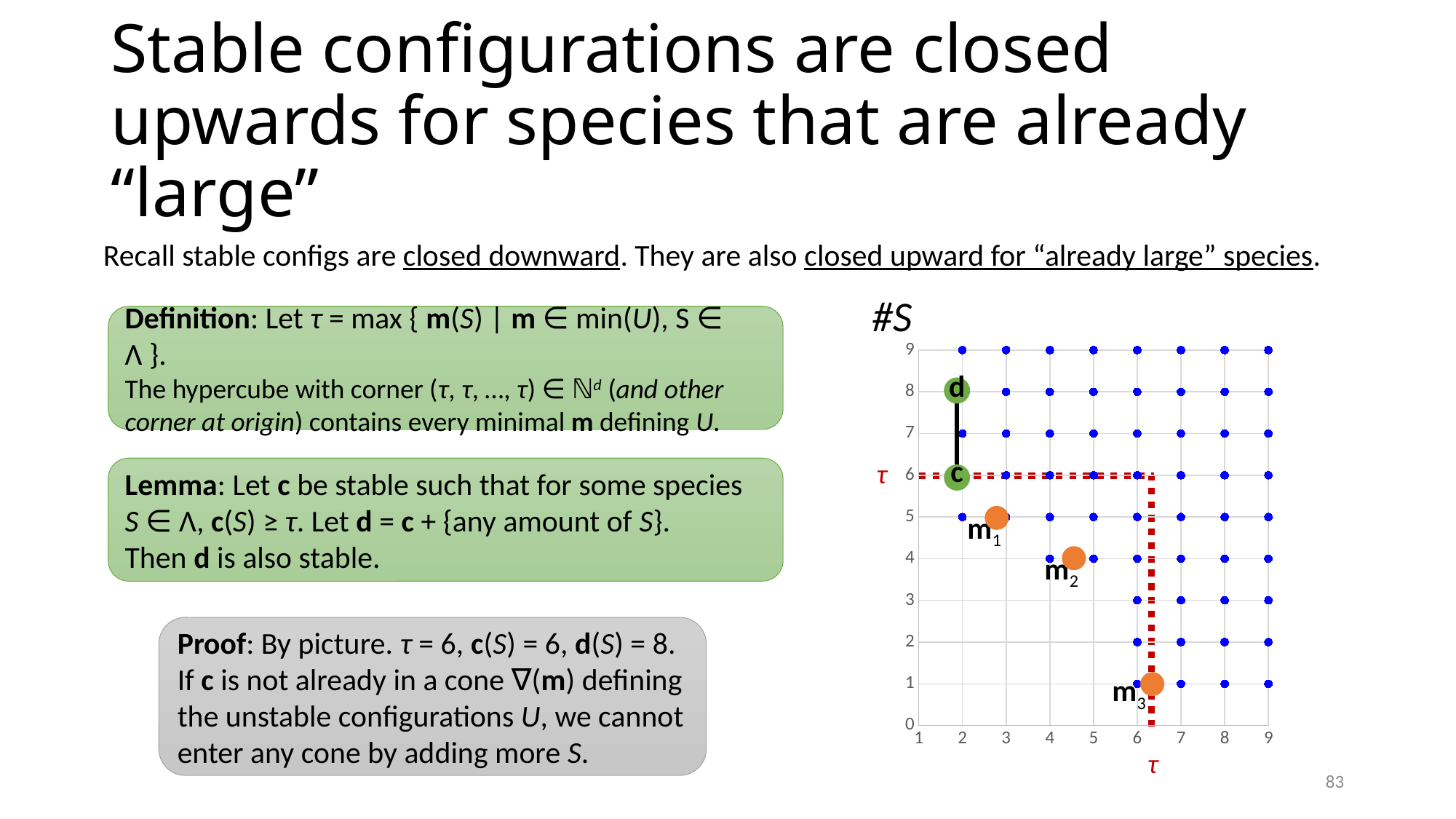
What is the #S (vertical) value of the point labelled c? 6 What is the label on the vertical axis of the chart? #S At what value on the axes are the dashed red τ lines drawn? 6 Which of the orange points m1, m2, m3 has the lowest #S value? m3 What kind of chart is shown on the right of the slide? scatter chart By how much does the #S value of d exceed that of c? 2 Is the horizontal-axis value of m3 greater or less than 5? greater What is the #S (vertical) value of the orange point m3? 1 What is the #S (vertical) value of the point labelled d? 8 How many orange points are plotted on the chart? 3 What is the #S (vertical) value of the orange point m1? 5 Which of the orange points m1, m2, m3 has the highest #S value? m1